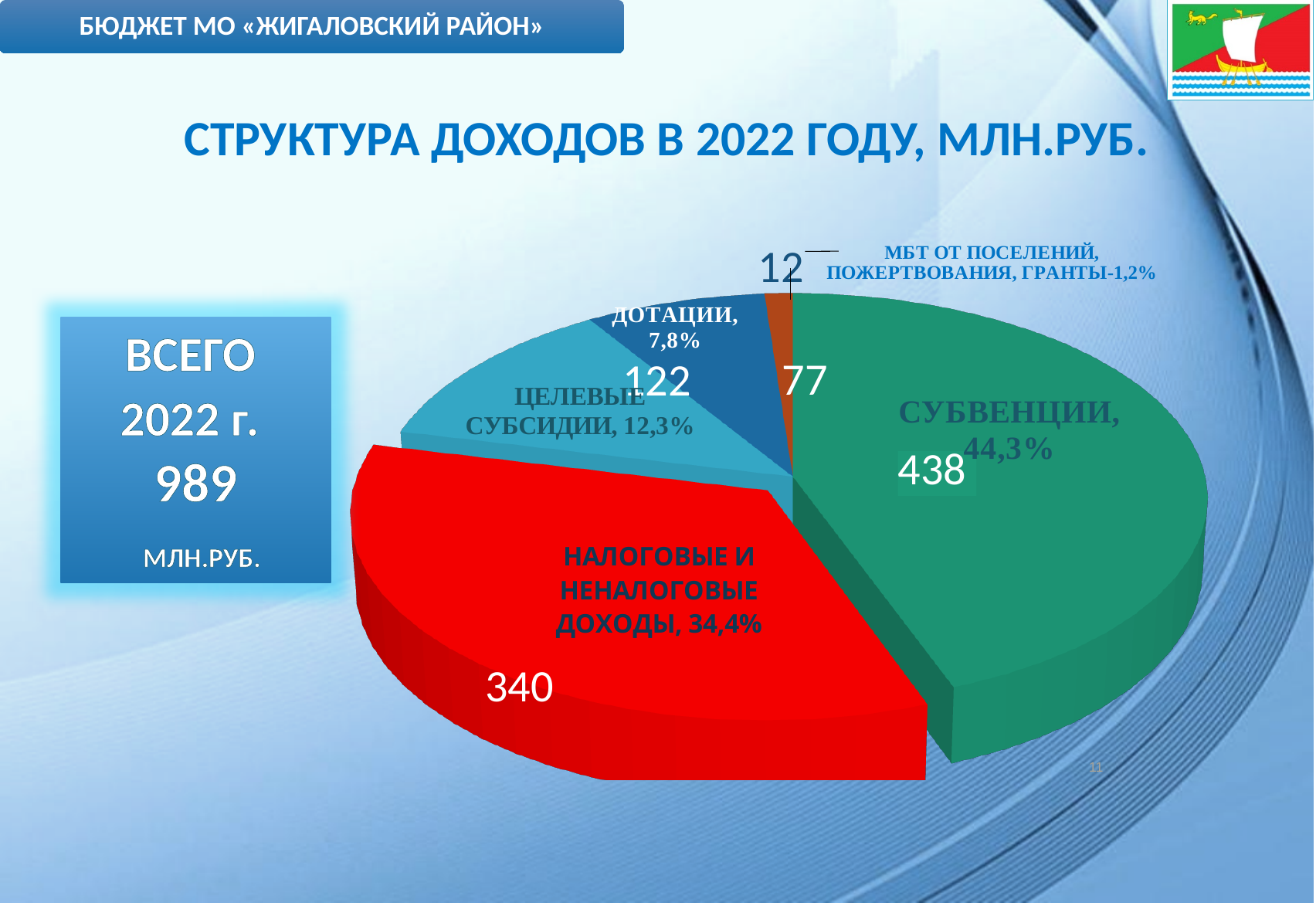
What is the title of the chart on the slide? СТРУКТУРА ДОХОДОВ В 2022 ГОДУ, МЛН.РУБ. How many slices does the pie chart have? 5 What type of chart is shown on the slide? pie chart Which category has the smallest slice in the pie chart? МБТ ОТ ПОСЕЛЕНИЙ, ПОЖЕРТВОВАНИЯ, ГРАНТЫ What is the value for the МБТ ОТ ПОСЕЛЕНИЙ, ПОЖЕРТВОВАНИЯ, ГРАНТЫ slice? 12 What share of the pie does ЦЕЛЕВЫЕ СУБСИДИИ represent? 12,3% What is the value for СУБВЕНЦИИ in the pie chart? 438 What share of the pie does ДОТАЦИИ represent? 7,8% What is the difference between the values for СУБВЕНЦИИ and НАЛОГОВЫЕ И НЕНАЛОГОВЫЕ ДОХОДЫ? 98 What is the value for НАЛОГОВЫЕ И НЕНАЛОГОВЫЕ ДОХОДЫ in the pie chart? 340 What share of the pie does СУБВЕНЦИИ represent? 44,3% Which category has the largest slice in the pie chart? СУБВЕНЦИИ